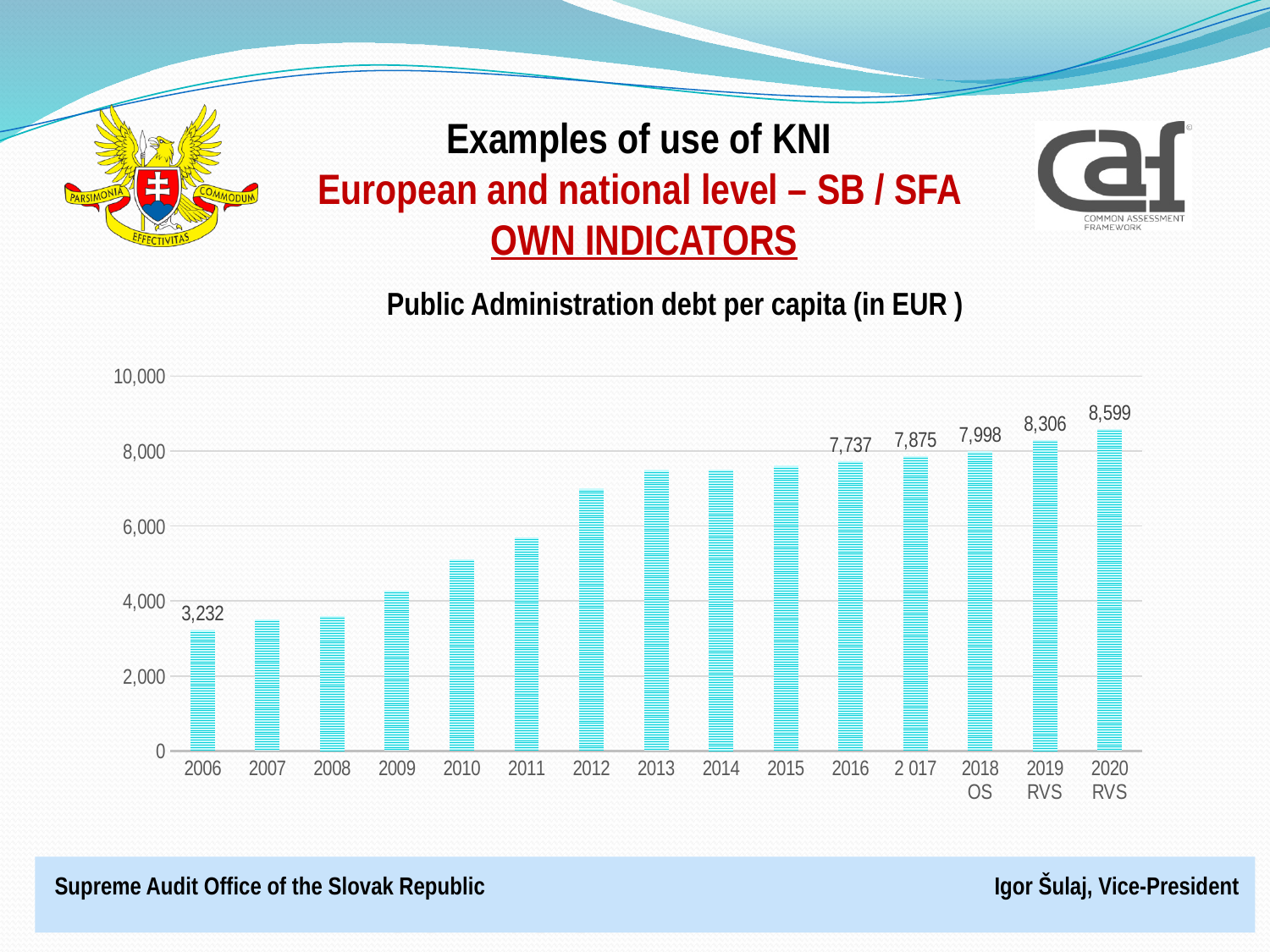
What is the difference between the debt per capita for 2020 RVS and 2019 RVS? 293 Which year has the lowest Public Administration debt per capita? 2006 What is the overall trend of Public Administration debt per capita from 2006 to 2020? rising Which year has the highest Public Administration debt per capita? 2020 RVS What type of chart is shown on the slide? bar chart What is the Public Administration debt per capita for 2018 OS? 7,998 What is the Public Administration debt per capita for 2020 RVS? 8,599 How many years (bars) are shown in the chart? 15 Is the debt per capita for 2010 greater or less than 6,000? less What is the Public Administration debt per capita for 2016? 7,737 What is the Public Administration debt per capita for 2006? 3,232 What is the difference between the debt per capita for 2020 RVS and 2006? 5,367